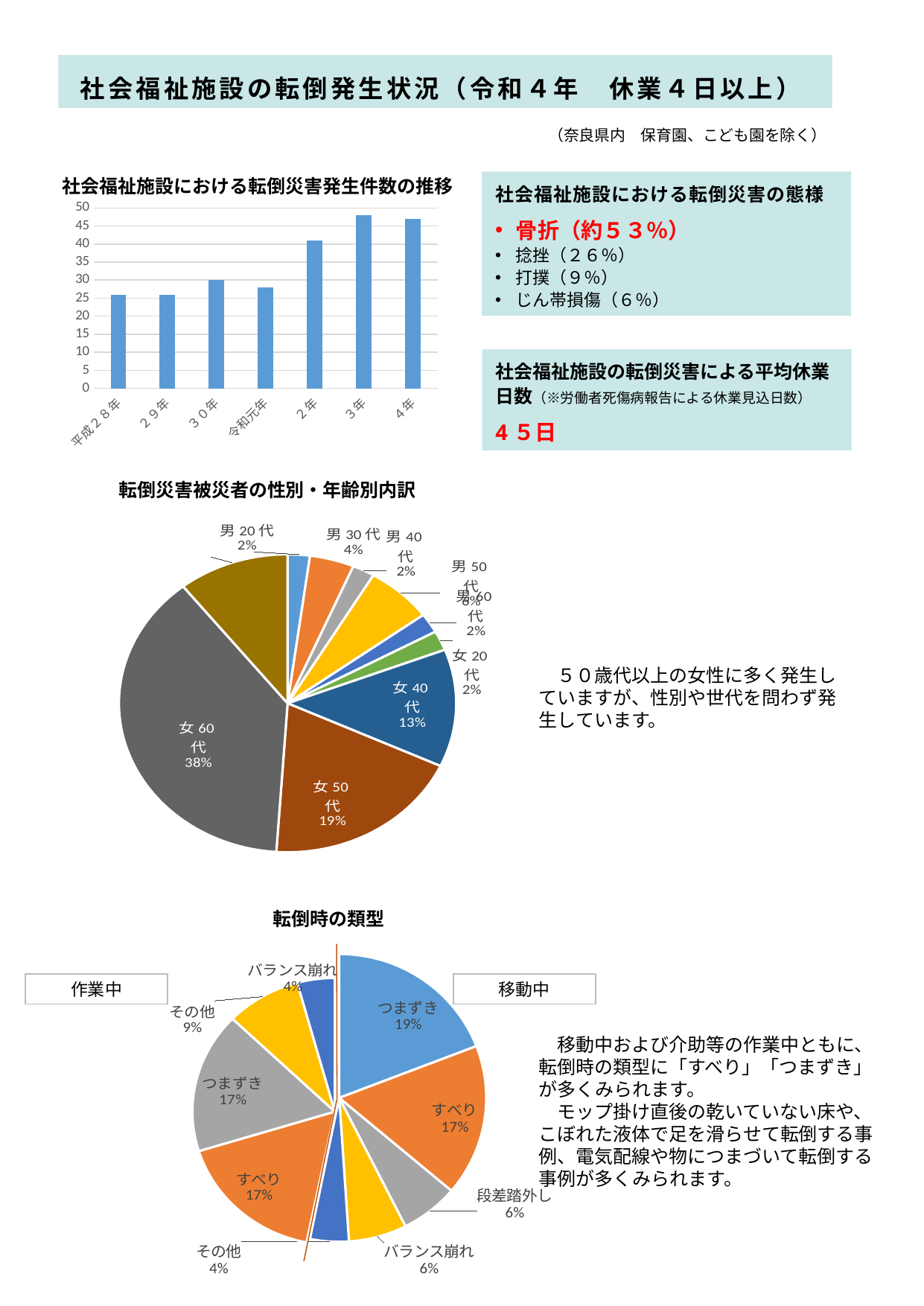
In the chart 社会福祉施設における転倒災害発生件数の推移, is the value for 2年 greater or less than 35? greater In the chart 社会福祉施設における転倒災害発生件数の推移, is the value for 3年 greater or less than 45? greater In the chart 社会福祉施設における転倒災害発生件数の推移, how many years are shown on the x axis? 7 In the pie chart 転倒災害被災者の性別・年齢別内訳, which is larger, 女40代 or 男50代? 女40代 In the chart 社会福祉施設における転倒災害発生件数の推移, is the value for 平成28年 greater or less than 30? less In the pie chart 転倒時の類型, what share is つまずき in the 移動中 group? 19% What type of chart is 社会福祉施設における転倒災害発生件数の推移? bar chart In the pie chart 転倒災害被災者の性別・年齢別内訳, which labelled slice is the largest? 女60代 In the pie chart 転倒時の類型, what share is 段差踏外し? 6% In the pie chart 転倒災害被災者の性別・年齢別内訳, what is the difference in percentage points between 女60代 and 女50代? 19 In the pie chart 転倒災害被災者の性別・年齢別内訳, what share is 女60代? 38% In the chart 社会福祉施設における転倒災害発生件数の推移, do the values generally rise or fall from 平成28年 to 4年? rise